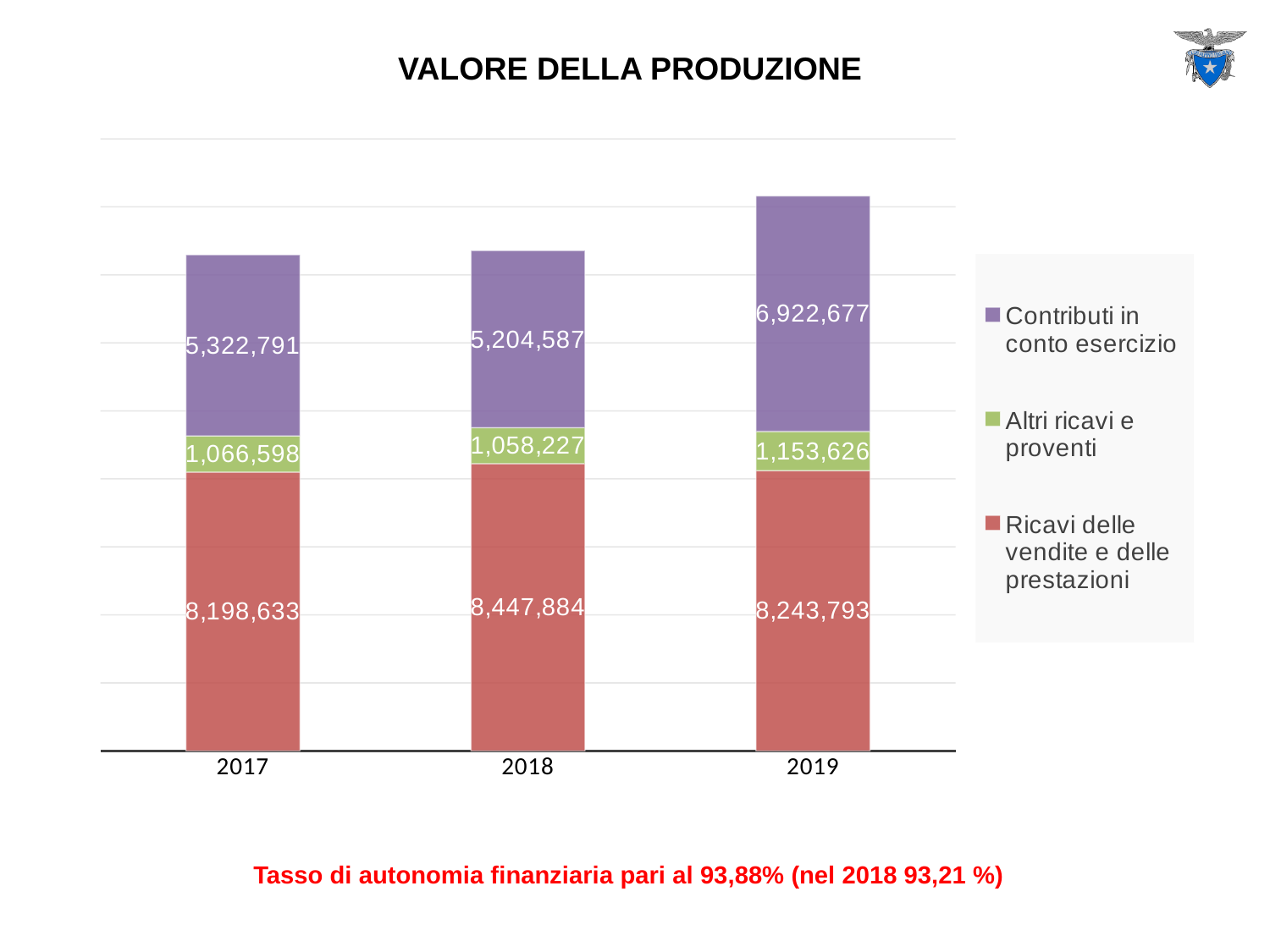
What type of chart is shown on the slide? Stacked bar chart In which year is Contributi in conto esercizio highest? 2019 What is the value of Contributi in conto esercizio for 2019? 6,922,677 What is the value of Ricavi delle vendite e delle prestazioni for 2018? 8,447,884 How many years are shown on the x axis? 3 How many series does the legend list? 3 What is the value of Altri ricavi e proventi for 2017? 1,066,598 What is the total value of the stacked bar for 2019? 16,320,096 Which is larger: Ricavi delle vendite e delle prestazioni in 2018 or in 2019? 2018 In which year is Altri ricavi e proventi lowest? 2018 What is the difference between Contributi in conto esercizio in 2019 and in 2018? 1,718,090 What is the title of the chart? VALORE DELLA PRODUZIONE